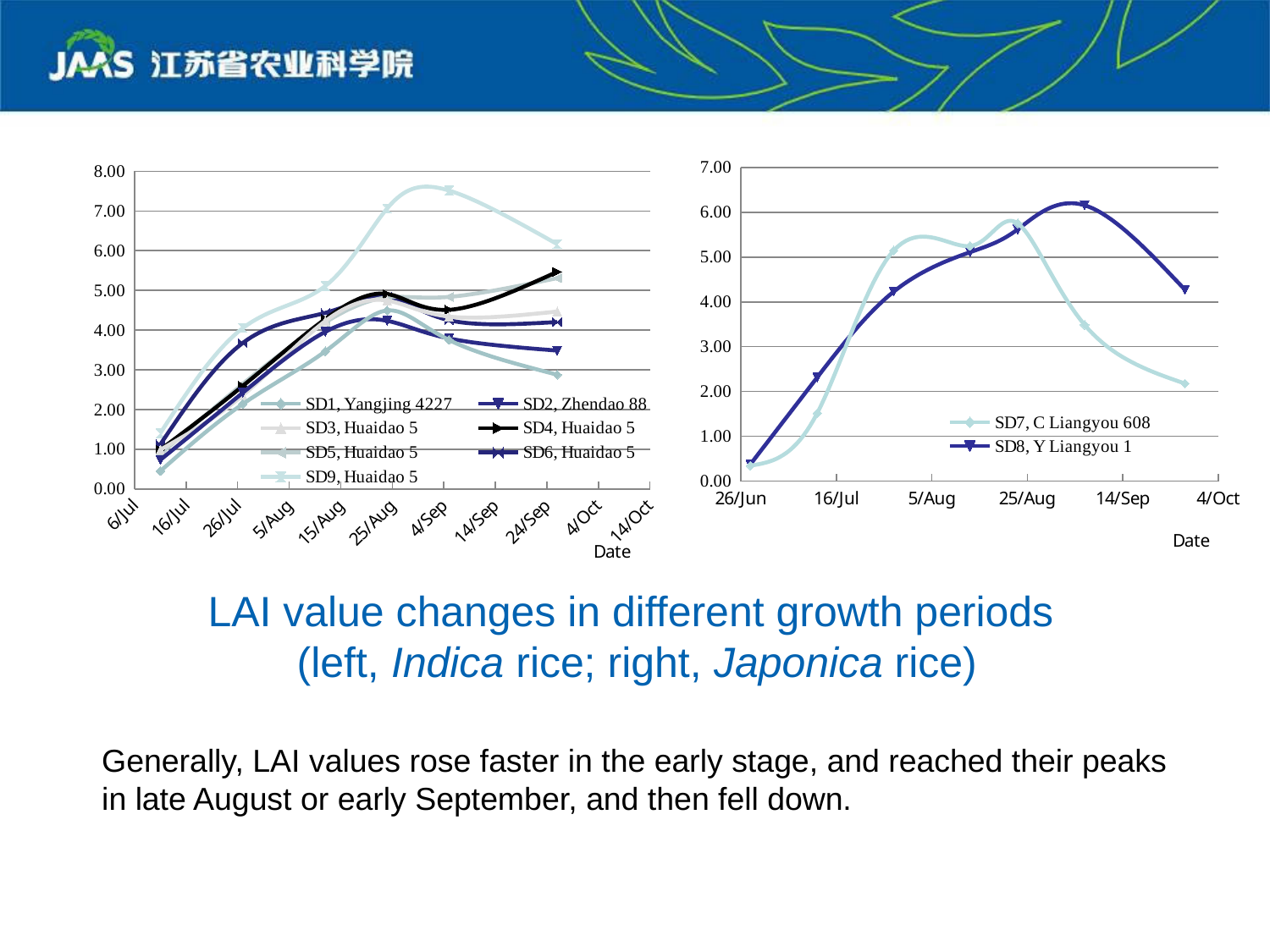
In the right chart, which series has the higher value at the last plotted date, SD7, C Liangyou 608 or SD8, Y Liangyou 1? SD8, Y Liangyou 1 How many series does the legend of the right chart list? 2 What is the maximum value shown on the y axis of the left chart? 8.00 In the left chart, which series reaches the highest LAI value? SD9, Huaidao 5 In the right chart, is the final value of SD7, C Liangyou 608 greater or less than 3.00? less How many series does the legend of the left chart list? 7 In the left chart, is the final value of SD4, Huaidao 5 greater or less than 5.00? greater In the left chart, is the peak value of SD9, Huaidao 5 greater or less than 7.00? greater In the right chart, does the value of SD7, C Liangyou 608 rise or fall between 25/Aug and 14/Sep? fall In the right chart, which series reaches a higher peak, SD7, C Liangyou 608 or SD8, Y Liangyou 1? SD8, Y Liangyou 1 What is the x-axis title of the right chart? Date What type of chart is the left chart on the slide? line chart